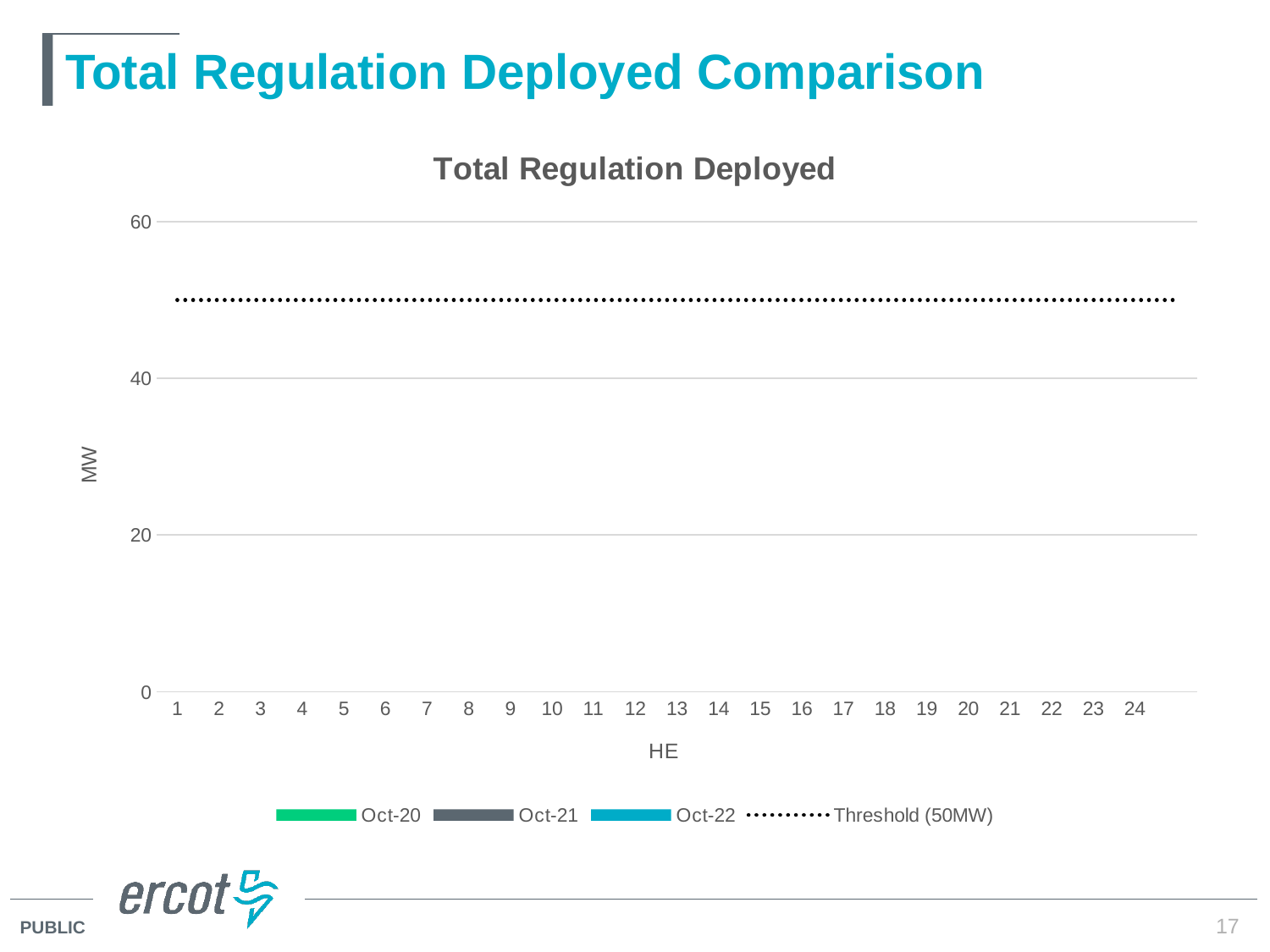
What value does the Threshold line in the legend represent? 50MW What unit is shown on the y axis label? MW How many hour-ending (HE) categories are shown on the x axis? 24 Is the dotted Threshold line plotted at a value greater or less than 40? greater Is the dotted Threshold line plotted at a value greater or less than 60? less How many series does the chart legend list? 4 What is the title of the chart? Total Regulation Deployed